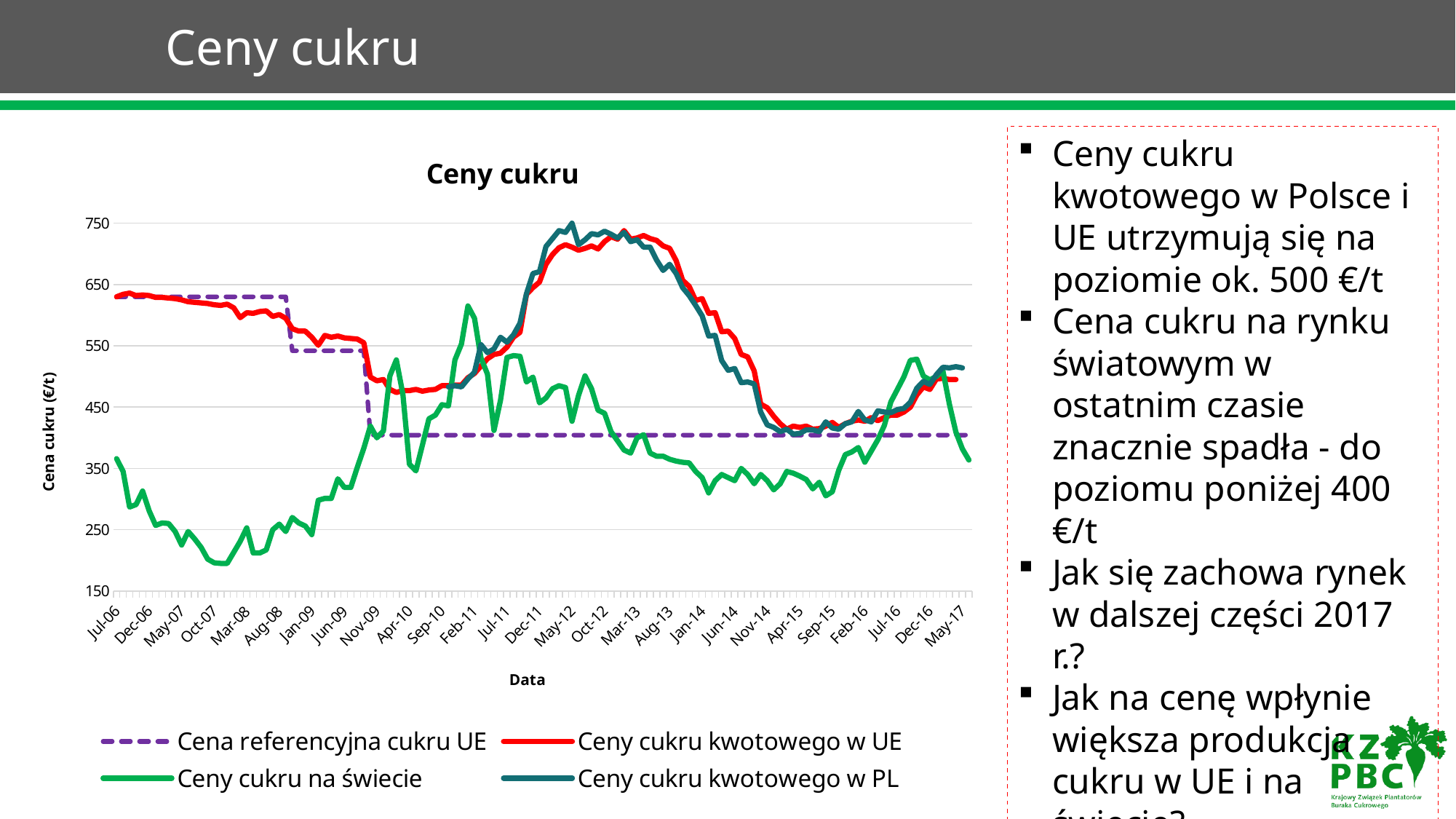
At Oct-07, which is higher: Cena referencyjna cukru UE or Ceny cukru na świecie? Cena referencyjna cukru UE Is the value for Ceny cukru na świecie at Oct-07 greater or less than 250? less Is the value for Ceny cukru kwotowego w UE at Mar-13 greater or less than 650? greater Is the value for Cena referencyjna cukru UE at Jul-06 greater or less than 550? greater What is the title of the chart? Ceny cukru Does the Ceny cukru kwotowego w UE series rise or fall between Mar-13 and Apr-15? fall How many series does the legend of the chart list? 4 Does the Ceny cukru na świecie series rise or fall between Jul-06 and Oct-07? fall What kind of chart is shown on the slide? line chart What is the label of the vertical axis of the chart? Cena cukru (€/t) Which series reaches the lowest value on the chart? Ceny cukru na świecie